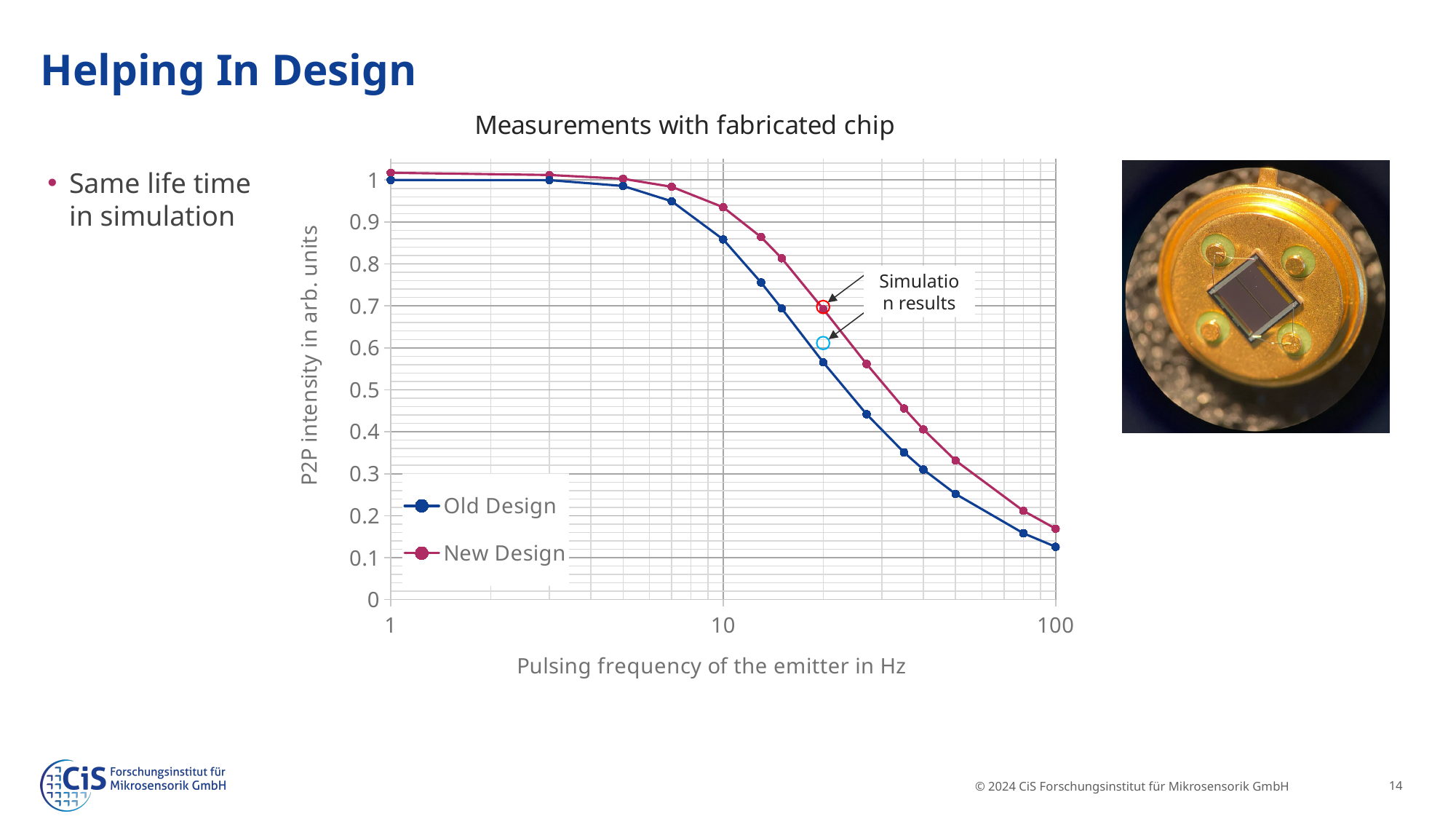
Is the New Design value at 10 Hz greater or less than 0.8? greater Is the New Design value at 100 Hz greater or less than 0.3? less What are the two series named in the legend? Old Design and New Design Is the Old Design value at 10 Hz greater or less than 0.8? greater What kind of chart is shown on the slide? Line chart At 10 Hz, which series has the lower P2P intensity, Old Design or New Design? Old Design How does the P2P intensity change as the pulsing frequency increases from 1 Hz to 100 Hz? It falls Which series stays higher across the whole frequency range, Old Design or New Design? New Design How many series does the legend list? 2 At 100 Hz, which series has the higher P2P intensity, Old Design or New Design? New Design What is the title of the chart? Measurements with fabricated chip